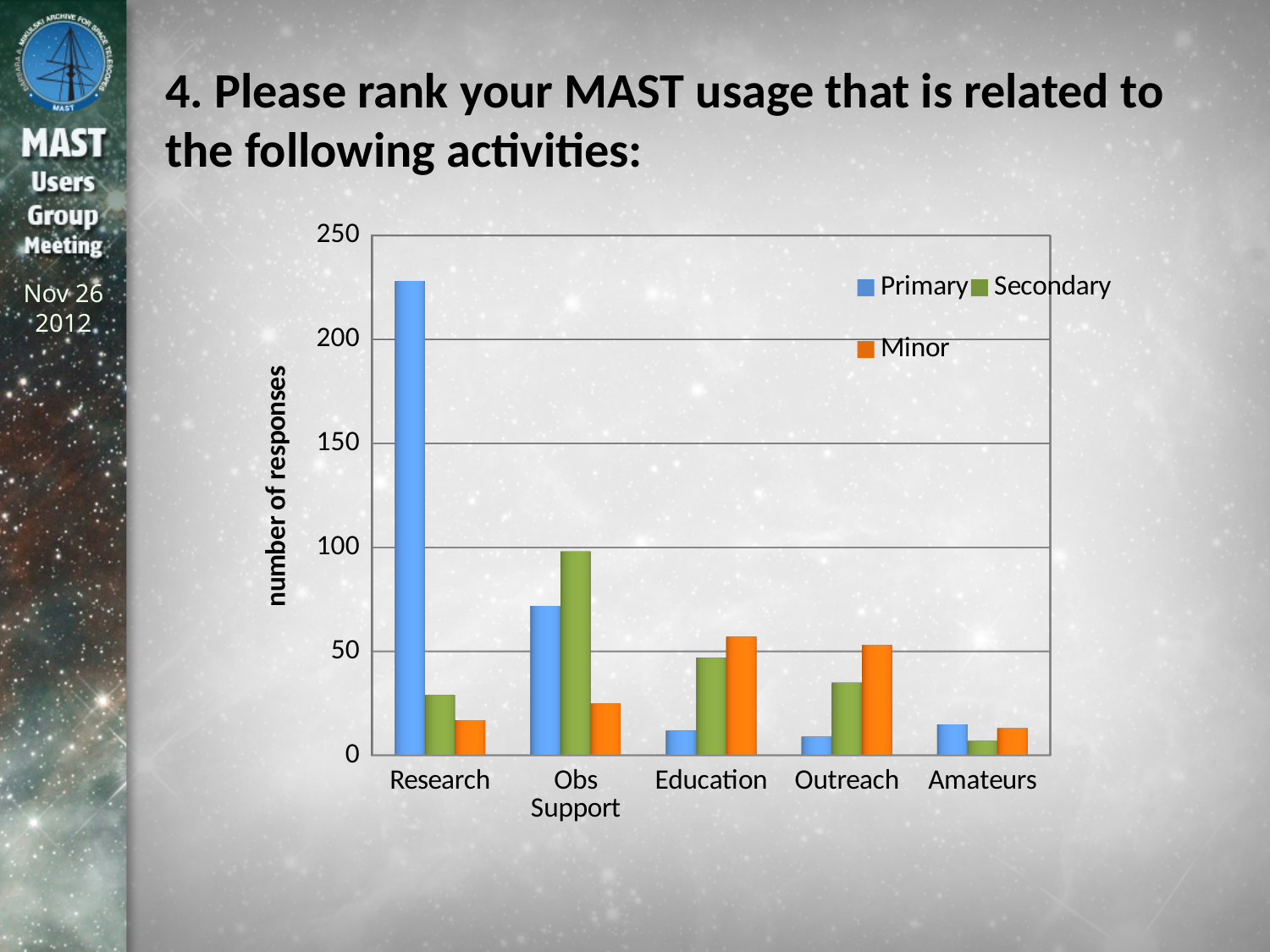
Is the Minor value for Education greater or less than 50? greater Is the Primary value for Research greater or less than 200? greater How many series does the legend list? 3 For Obs Support, which is larger, the Primary value or the Secondary value? Secondary Which activity has the highest Primary value? Research For Education, which is larger, the Primary value or the Minor value? Minor Which activity has the lowest Secondary value? Amateurs What kind of chart is shown on the slide? bar chart What is the label of the vertical axis? number of responses How many activity categories are shown on the x axis? 5 Which activity has the highest Secondary value? Obs Support